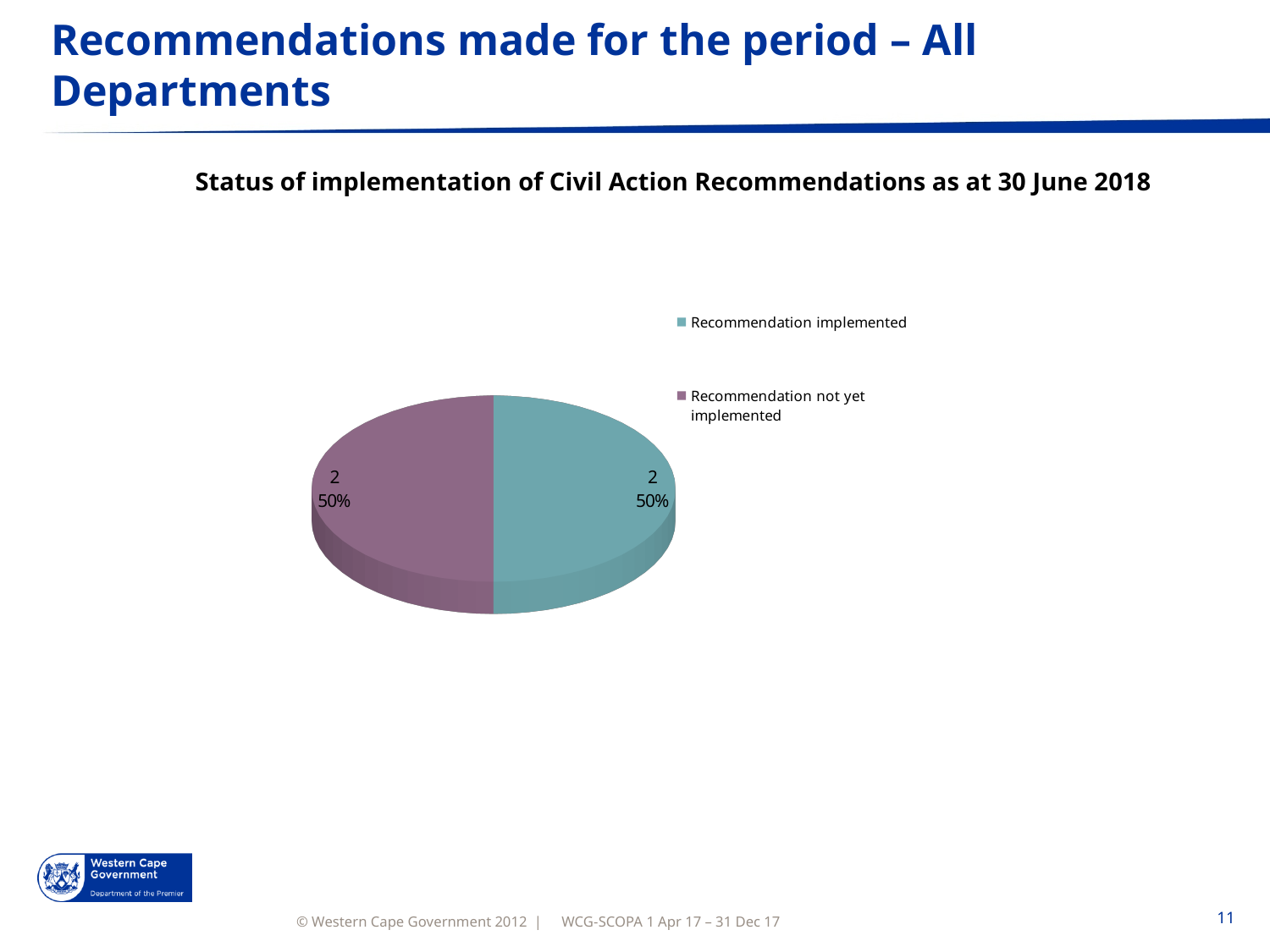
What is the value for Recommendation implemented? 2 What kind of chart is shown on the slide? Pie chart What is the value for Recommendation not yet implemented? 2 What share of the pie is Recommendation not yet implemented? 50% What share of the pie is Recommendation implemented? 50% What is the difference between the values for Recommendation implemented and Recommendation not yet implemented? 0 What is the title of the chart? Status of implementation of Civil Action Recommendations as at 30 June 2018 Which colour represents Recommendation not yet implemented in the legend? Purple How many entries does the legend list? 2 How many slices does the pie chart have? 2 What is the total of all slices in the pie chart? 4